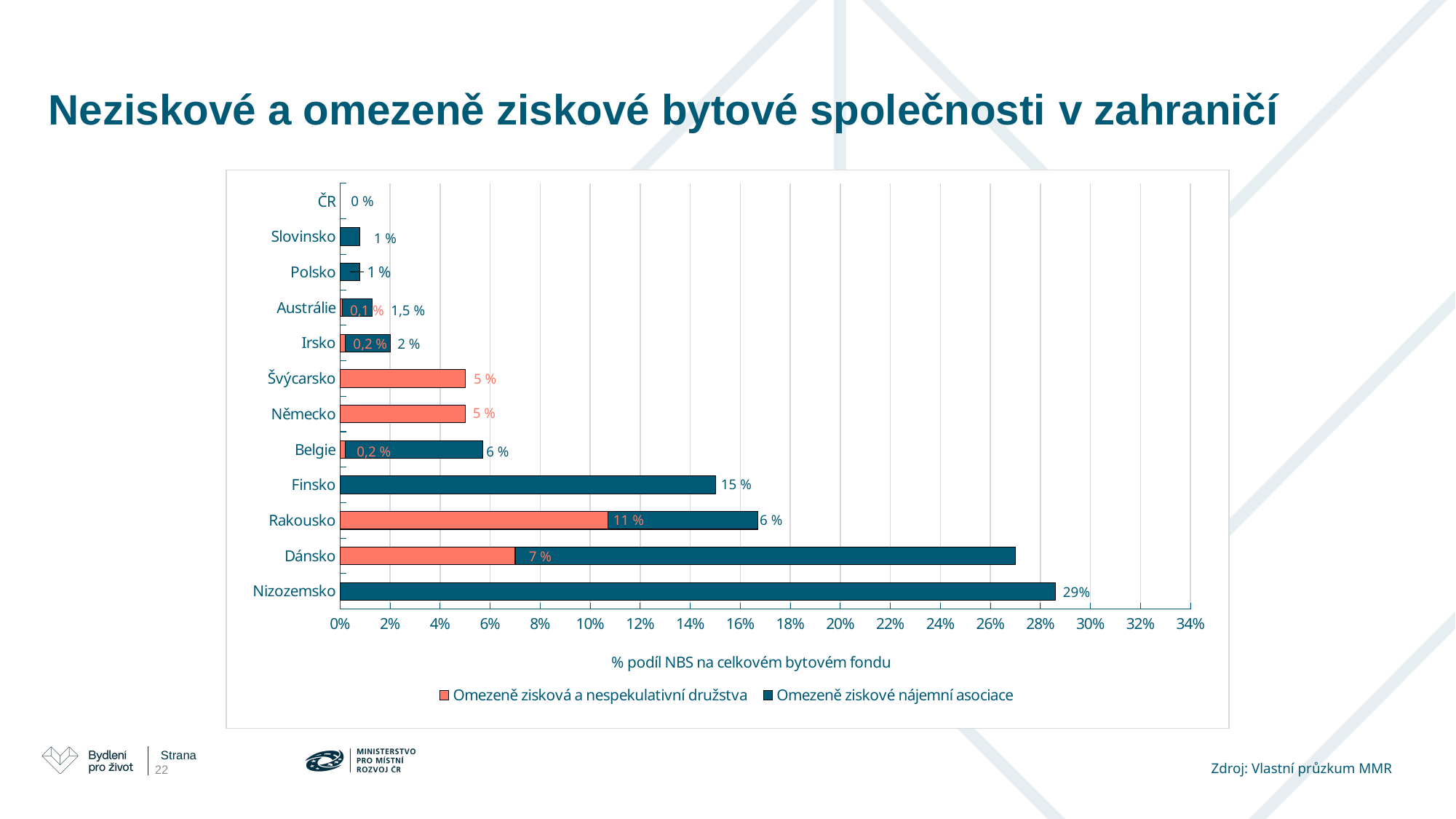
How many series does the legend list? 2 What kind of chart is shown on the slide? Bar chart Which country has the longest total bar? Nizozemsko What is the difference between the 'Omezeně ziskové nájemní asociace' values for Finsko and Belgie? 9 % What is the value of the 'Omezeně zisková a nespekulativní družstva' series for Rakousko? 11 % What is the total of the stacked bar for Rakousko? 17 % What is the value shown for Nizozemsko? 29% Is the total bar for Dánsko greater or less than 20%? greater Which is larger: the 'Omezeně ziskové nájemní asociace' value for Finsko or for Rakousko? Finsko What is the value of the 'Omezeně ziskové nájemní asociace' series for Finsko? 15 % How many countries are listed on the chart? 12 What is the value of the 'Omezeně zisková a nespekulativní družstva' series for Dánsko? 7 %